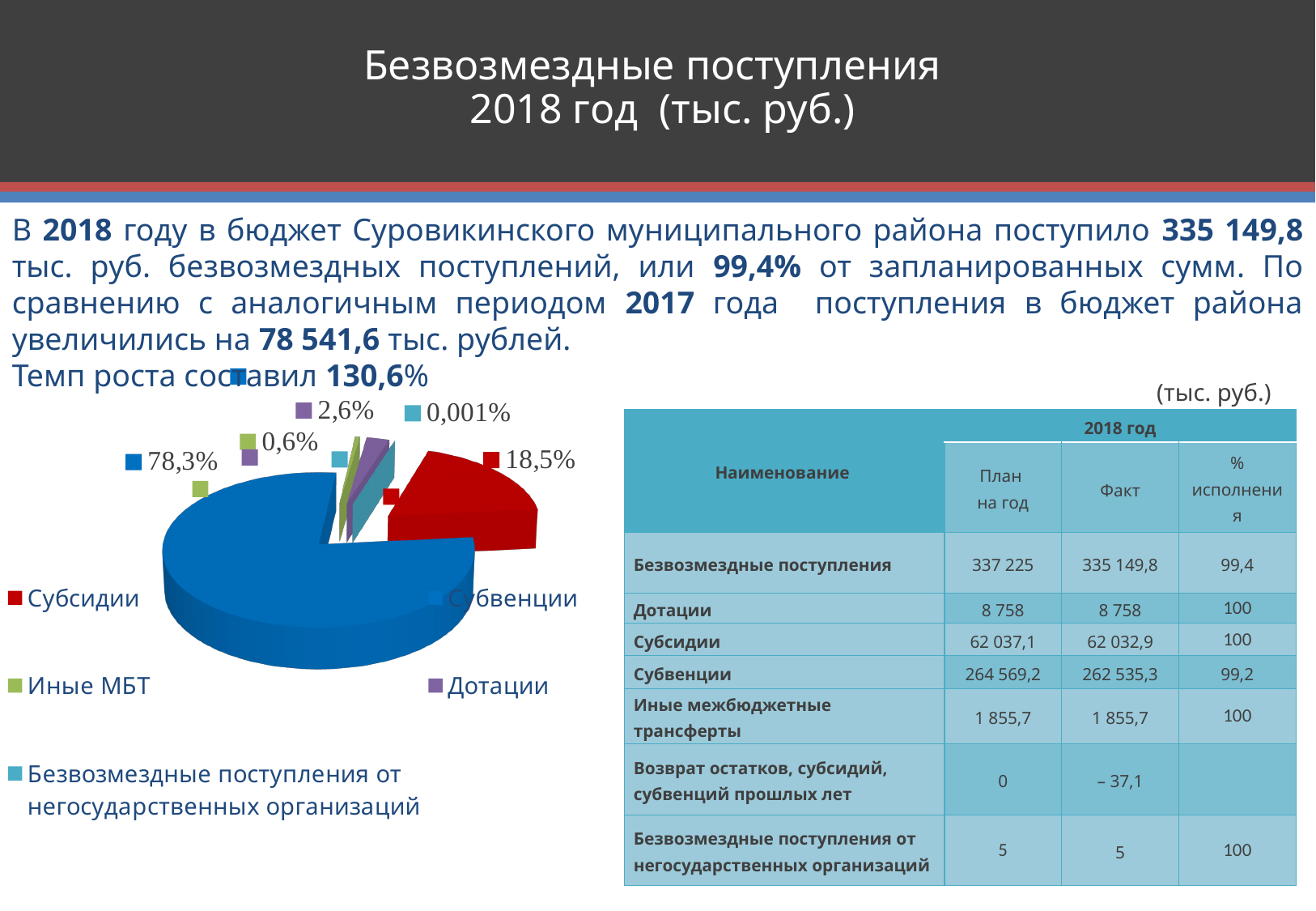
What share of the pie chart does Иные МБТ have? 0,6% What colour is the Субсидии slice in the pie chart? red What share of the pie chart does Безвозмездные поступления от негосударственных организаций have? 0,001% Which slice is larger in the pie chart: Субсидии or Дотации? Субсидии What kind of chart is shown on the slide? pie chart How many categories does the pie chart legend list? 5 What share of the pie chart does Субсидии have? 18,5% What share of the pie chart does Субвенции have? 78,3% Which category has the largest slice of the pie chart? Субвенции What share of the pie chart does Дотации have? 2,6% What is the difference in percentage points between the Субвенции and Субсидии slices? 59,8 Which category has the smallest slice of the pie chart? Безвозмездные поступления от негосударственных организаций